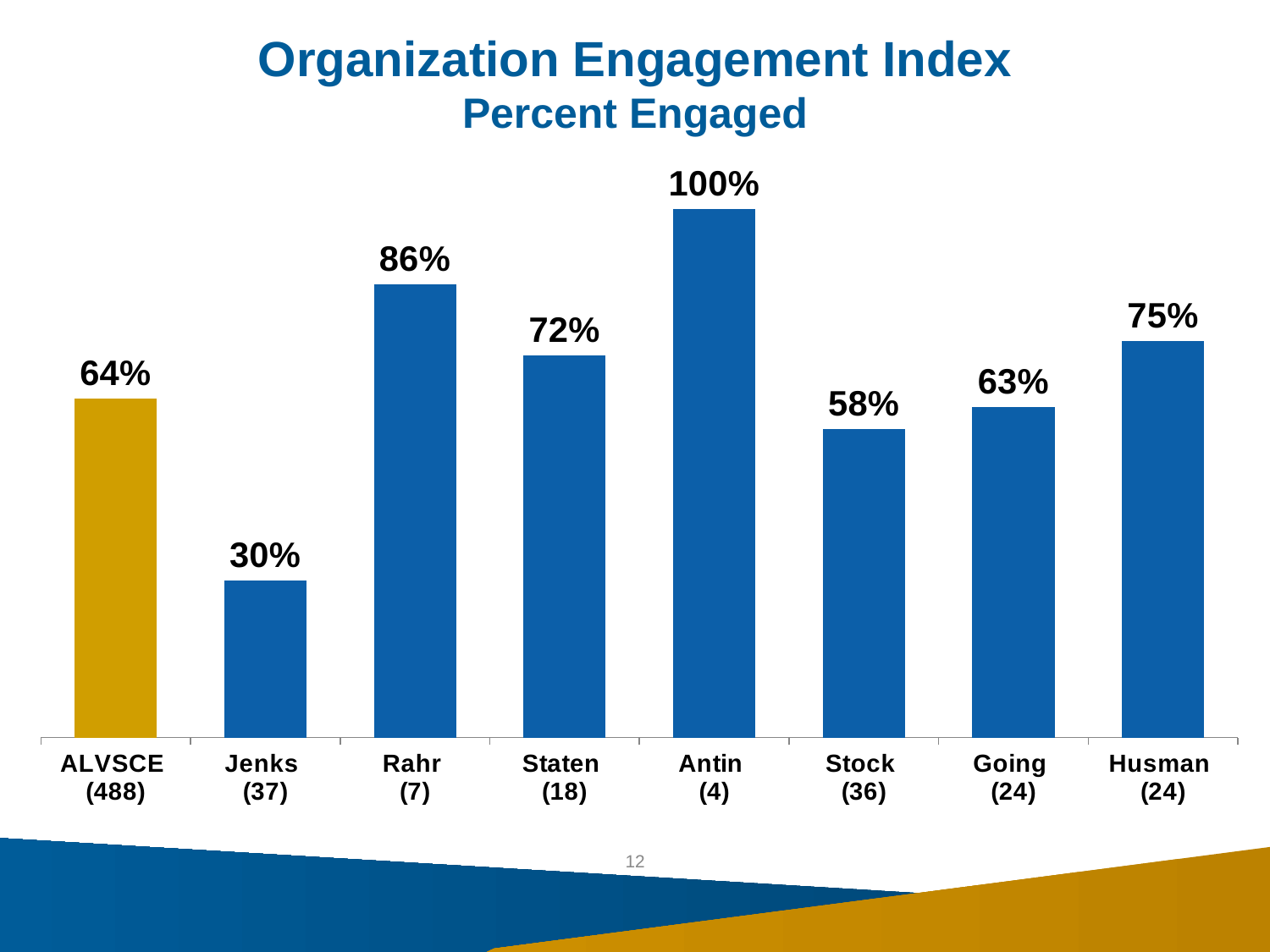
What is the difference in percent engaged between Antin and Jenks? 70% Which has a higher percent engaged, Staten or Stock? Staten How many categories are shown in the chart? 8 What is the percent engaged for Rahr? 86% What is the percent engaged for ALVSCE? 64% What is the title of the chart? Organization Engagement Index Which bar is shown in a different colour (gold) from the others? ALVSCE Which category has the highest percent engaged? Antin Which category has the lowest percent engaged? Jenks What is the percent engaged for Stock? 58% What is the difference in percent engaged between Husman and Going? 12% What kind of chart is shown on the slide? Bar chart